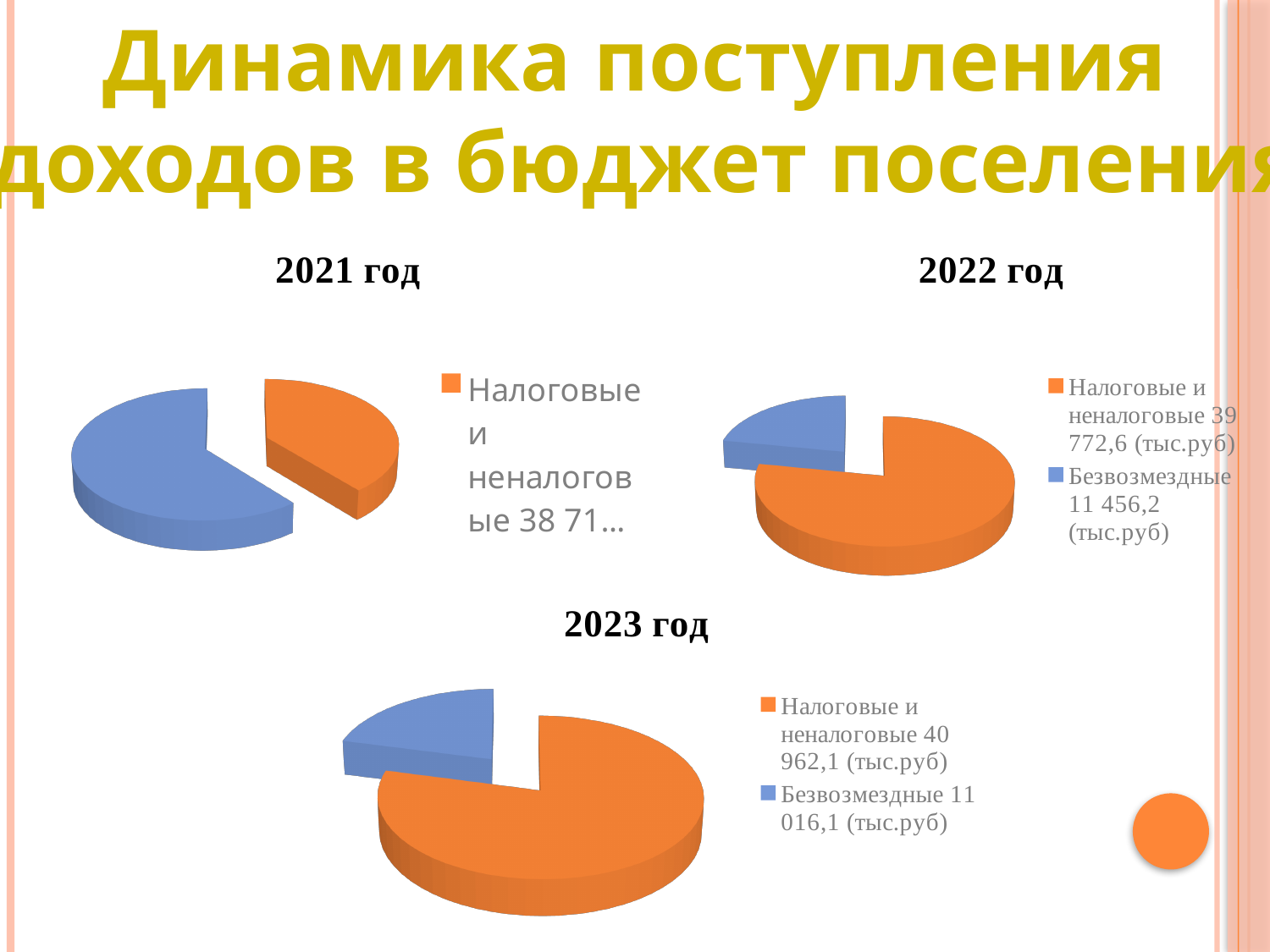
In the 2022 год chart, how much larger is Налоговые и неналоговые than Безвозмездные? 28 316,4 (тыс.руб) In the 2022 год chart, which category has the smallest slice? Безвозмездные In the 2023 год chart, what is the value for Налоговые и неналоговые? 40 962,1 (тыс.руб) In the 2023 год chart, what is the value for Безвозмездные? 11 016,1 (тыс.руб) What is the total of the two values shown in the 2023 год chart? 51 978,2 (тыс.руб) What kind of chart is used for the 2022 год data? Pie chart In the 2021 год chart, is the orange slice larger or smaller than the blue slice? Smaller In the 2023 год chart, which category has the largest slice? Налоговые и неналоговые How many entries does the legend of the 2023 год chart list? 2 How many pie charts are shown on the slide? 3 In the 2022 год chart, what is the value for Налоговые и неналоговые? 39 772,6 (тыс.руб) In the 2022 год chart, what is the value for Безвозмездные? 11 456,2 (тыс.руб)